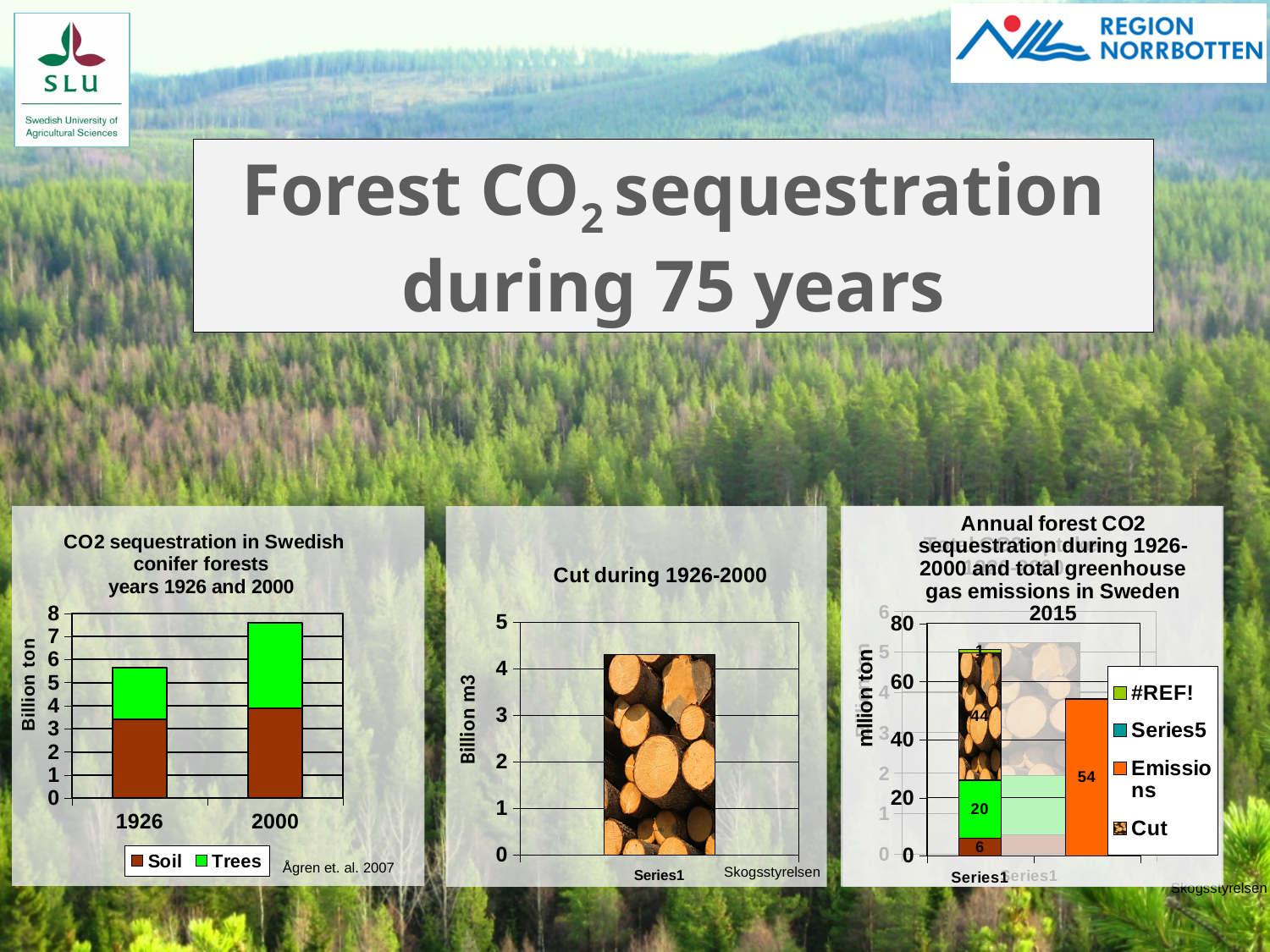
In the left chart 'CO2 sequestration in Swedish conifer forests', what is the y-axis label? Billion ton In the left chart 'CO2 sequestration in Swedish conifer forests', is the Soil value for 1926 greater or less than 4? less In the middle chart 'Cut during 1926-2000', is the value of the bar greater or less than 4? greater In the left chart 'CO2 sequestration in Swedish conifer forests', how many series does the legend list? 2 In the left chart 'CO2 sequestration in Swedish conifer forests', which two series are shown in the legend? Soil and Trees In the left chart 'CO2 sequestration in Swedish conifer forests', is the total value for 2000 greater or less than 7? greater In the right chart 'Annual forest CO2 sequestration during 1926-2000 and total greenhouse gas emissions in Sweden 2015', how many entries does the legend list? 4 What type of chart is the left chart titled 'CO2 sequestration in Swedish conifer forests years 1926 and 2000'? bar chart How many bars are plotted in the middle chart 'Cut during 1926-2000'? 1 In the left chart 'CO2 sequestration in Swedish conifer forests', which year has the taller total bar, 1926 or 2000? 2000 In the right chart 'Annual forest CO2 sequestration during 1926-2000 and total greenhouse gas emissions in Sweden 2015', what is the largest labelled segment value in the stacked bar? 44 In the right chart 'Annual forest CO2 sequestration during 1926-2000 and total greenhouse gas emissions in Sweden 2015', what value is labelled on the Emissions bar? 54